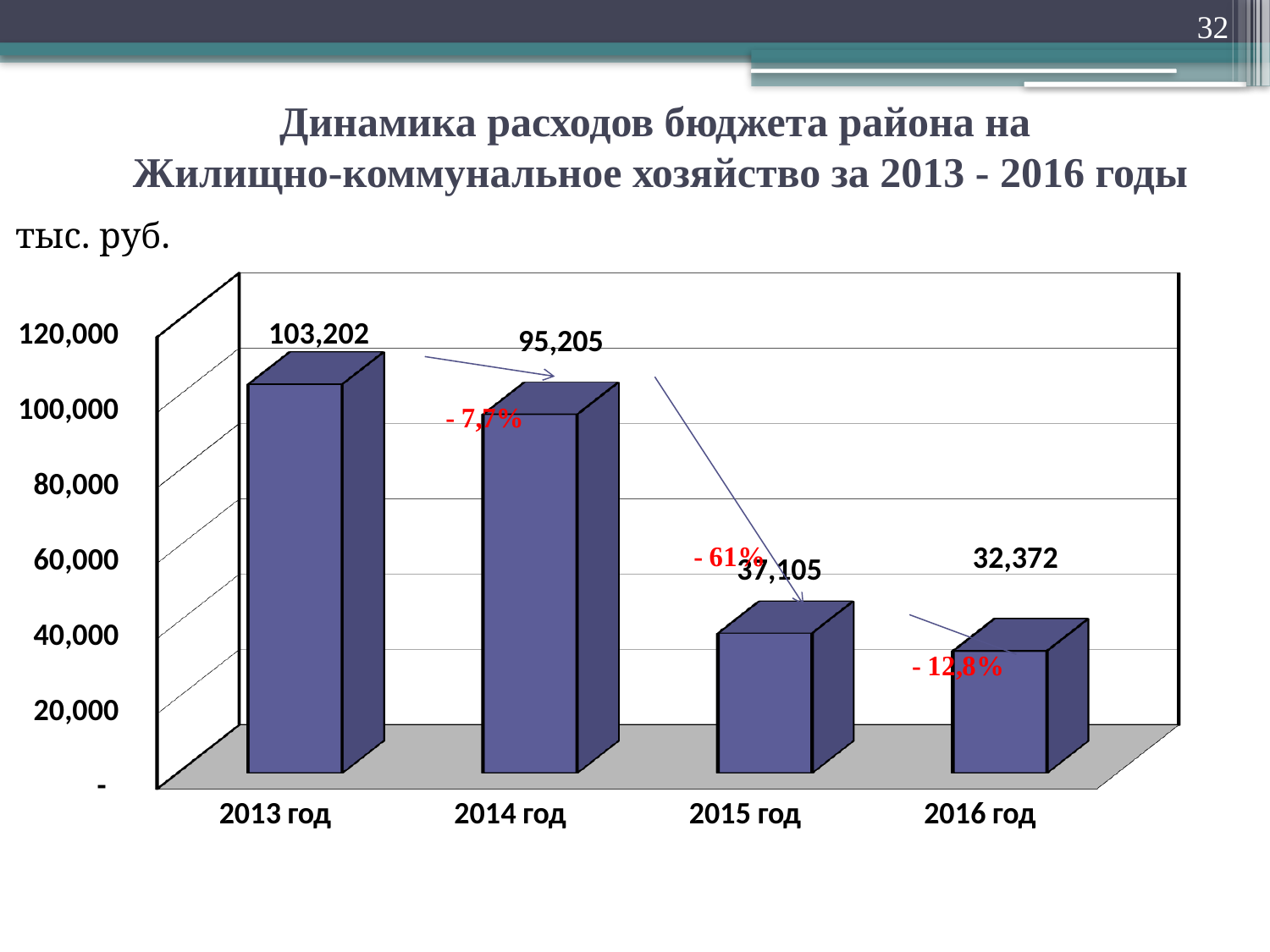
How many years are shown on the x axis? 4 Is the value for 2016 год greater or less than 40,000? less Do the values rise or fall from 2013 год to 2016 год? fall Which is larger, the value for 2014 год or the value for 2015 год? 2014 год What is the value for 2016 год? 32,372 What is the difference between the values for 2015 год and 2016 год? 4,733 Which year has the lowest value? 2016 год What is the difference between the values for 2013 год and 2014 год? 7,997 What is the value for 2015 год? 37,105 What kind of chart is shown on the slide? bar chart Which year has the highest value? 2013 год What is the value for 2013 год? 103,202